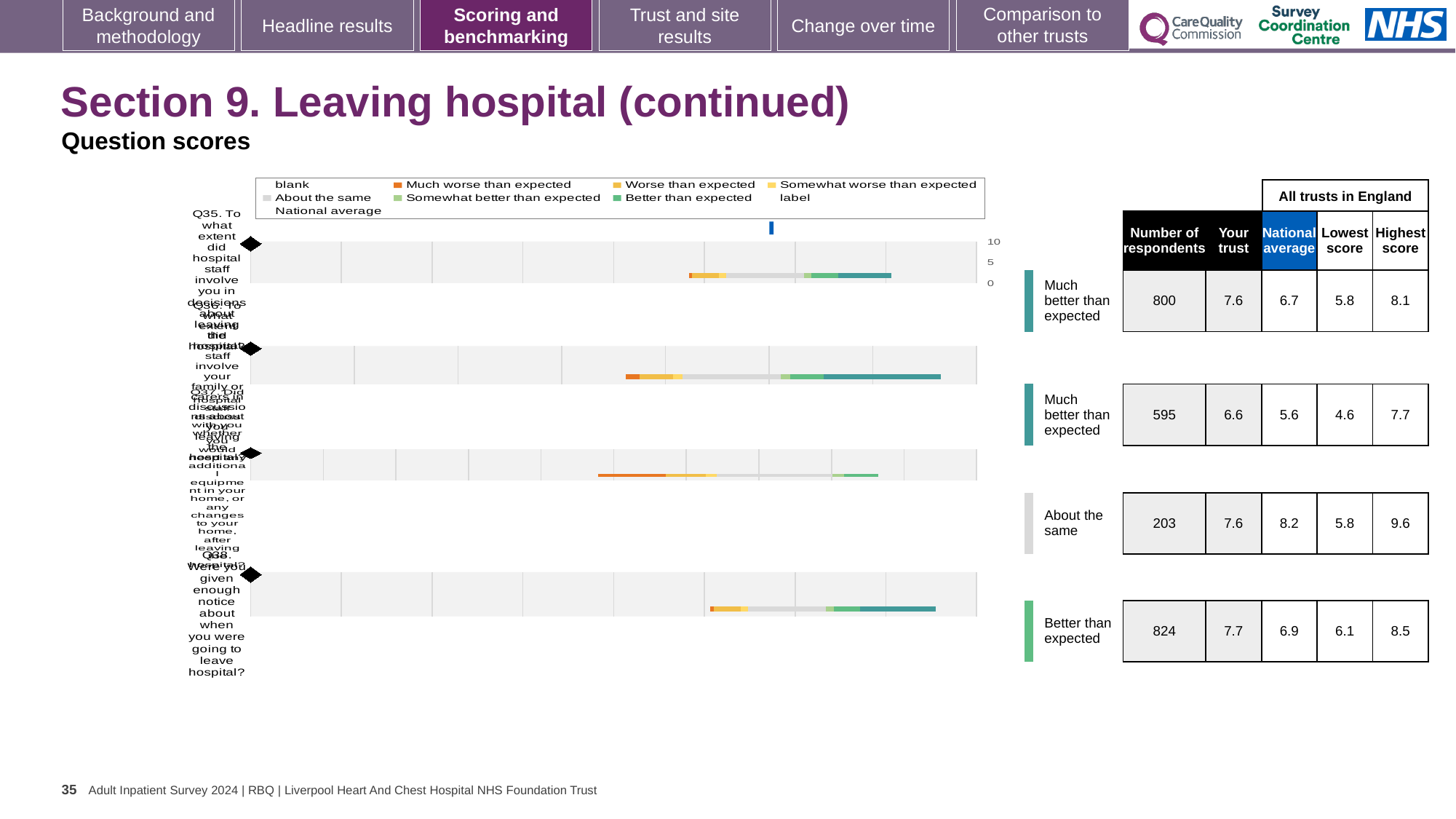
In the table beside the chart, is the 'Your trust' score in the second row (595 respondents) larger or smaller than the national average in that row? larger Which question number is plotted in the bottom bar of the chart? Q38 In the table beside the chart, what is the number of respondents in the row labelled 'About the same'? 203 In the table beside the chart, which row has the lowest number of respondents? About the same (203) What kind of chart is shown on the slide? bar chart How many question bars are plotted in the chart? 4 In the table beside the chart, what is the national average in the first row (labelled 'Much better than expected')? 6.7 In the table beside the chart, what is the 'Your trust' score in the first row (labelled 'Much better than expected')? 7.6 In the table beside the chart, which row has the highest number of respondents? Better than expected (824) In the table beside the chart, what is the highest score in the row labelled 'Better than expected'? 8.5 Which question number is plotted in the top bar of the chart? Q35 In the table beside the chart, what is the difference between 'Your trust' and the national average in the row labelled 'About the same'? 0.6